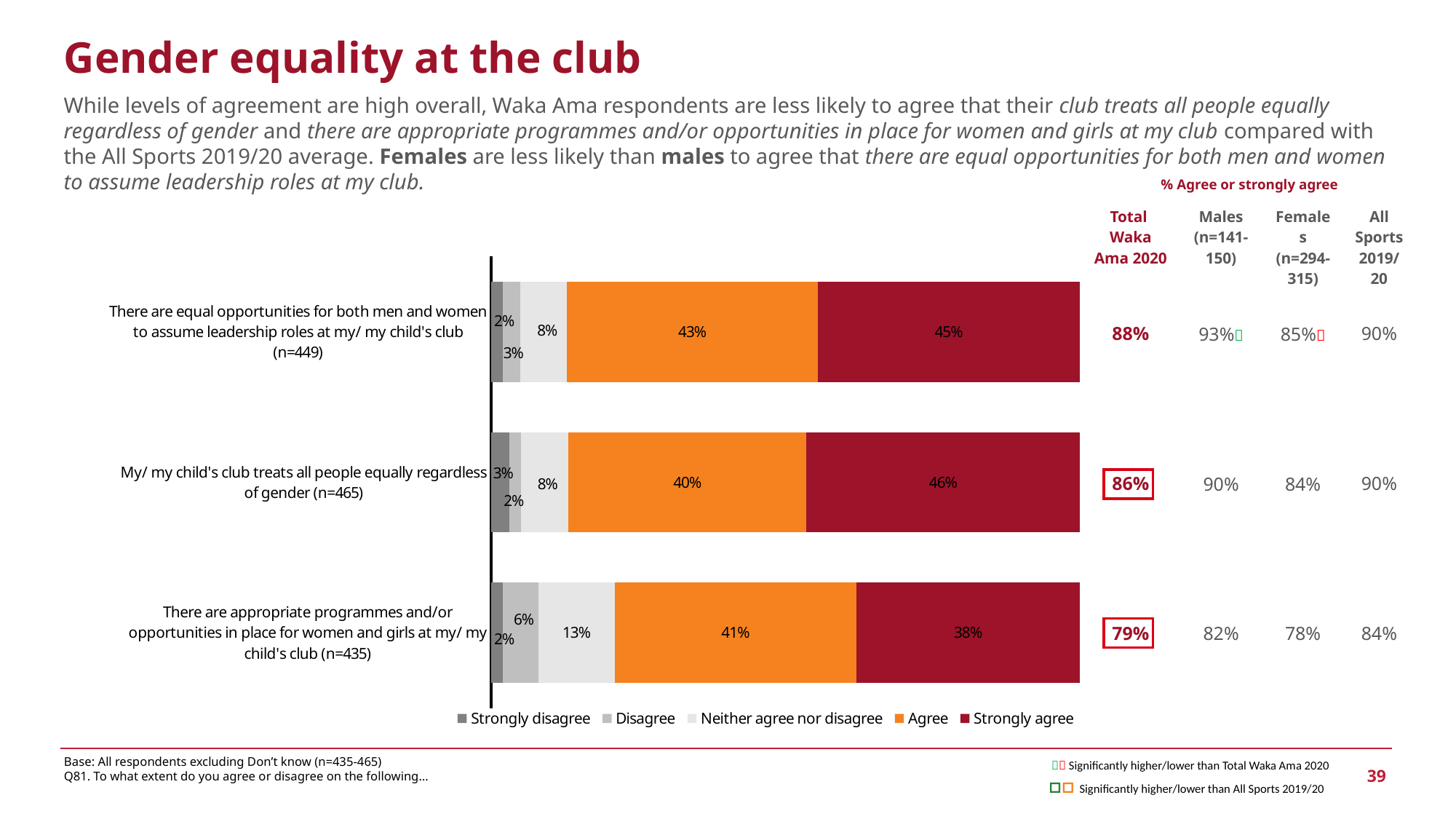
What is the 'Neither agree nor disagree' value for the statement about appropriate programmes and/or opportunities for women and girls? 13% How many series does the chart legend list? 5 How many statements (categories) are plotted in the chart? 3 Which statement has the highest 'Strongly agree' percentage? My/ my child's club treats all people equally regardless of gender In the '% Agree or strongly agree' table, what is the Total Waka Ama 2020 value for the statement about appropriate programmes and/or opportunities for women and girls? 79% Which statement has the lowest 'Strongly agree' percentage? There are appropriate programmes and/or opportunities in place for women and girls at my/ my child's club What is the 'Strongly agree' value for 'There are appropriate programmes and/or opportunities in place for women and girls at my/ my child's club'? 38% What kind of chart is shown on the slide? Stacked bar chart For 'There are equal opportunities for both men and women to assume leadership roles', which is larger: 'Agree' or 'Strongly agree'? Strongly agree What is the first entry in the chart legend? Strongly disagree What percentage of respondents 'Agree' that their club treats all people equally regardless of gender? 40% For the statement about appropriate programmes and/or opportunities for women and girls, what is the difference between the 'Agree' and 'Strongly agree' values? 3 percentage points